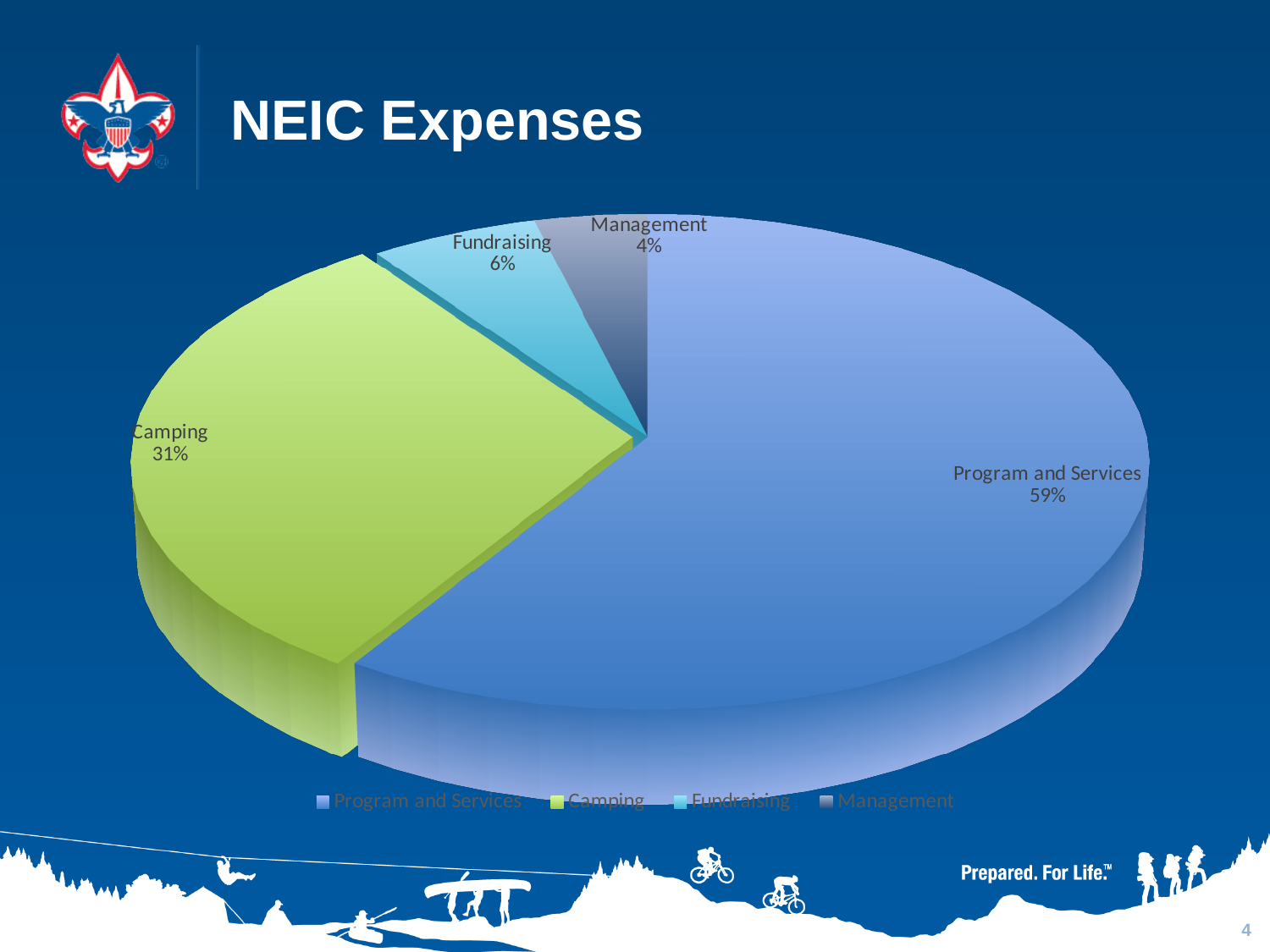
What percentage of the pie is Camping? 31% Which expense category has the smallest share? Management What share of NEIC expenses goes to Program and Services? 59% Which is larger, the Fundraising share or the Management share? Fundraising What colour is the Camping slice? Green What type of chart is shown on the slide? Pie chart What percentage of expenses is Management? 4% What is the difference in percentage points between Program and Services and Camping? 28 What is the title of the slide? NEIC Expenses How many categories are shown in the pie chart? 4 What share of expenses is Fundraising? 6% Which expense category has the largest share? Program and Services